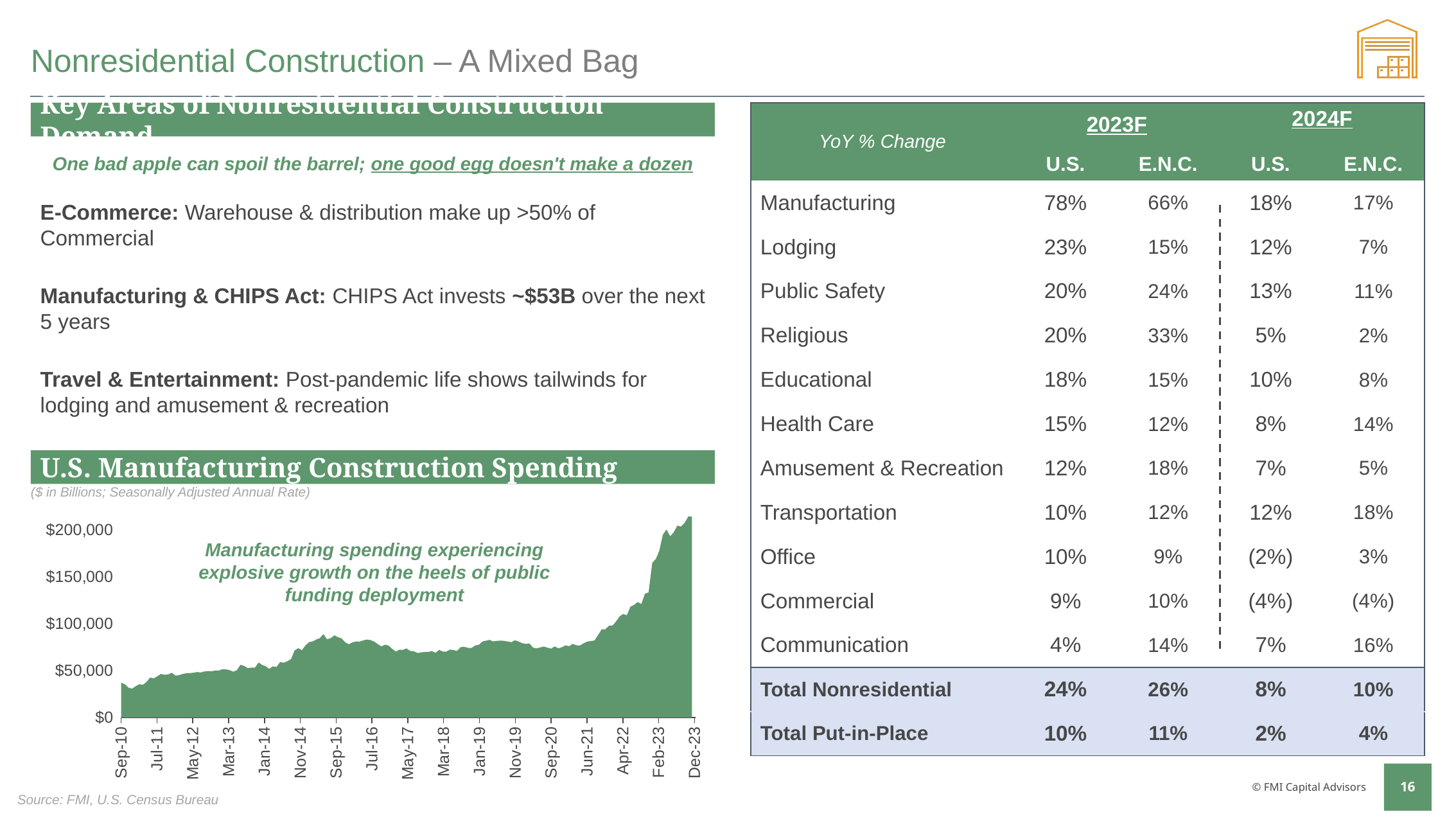
In the U.S. Manufacturing Construction Spending chart, do values generally rise or fall from Sep-10 to Dec-23? Rise In the U.S. Manufacturing Construction Spending chart, is the value at Feb-23 greater or less than $150,000? greater In the U.S. Manufacturing Construction Spending chart, which labeled period on the x axis has the highest value? Dec-23 What units does the subtitle of the U.S. Manufacturing Construction Spending chart state? $ in Billions; Seasonally Adjusted Annual Rate In the U.S. Manufacturing Construction Spending chart, is the value at Sep-15 greater or less than $100,000? less What kind of chart is the U.S. Manufacturing Construction Spending chart? Area chart In the U.S. Manufacturing Construction Spending chart, which labeled period on the x axis has the lowest value? Sep-10 In the U.S. Manufacturing Construction Spending chart, is the value at Sep-10 greater or less than $50,000? less What is the highest tick label on the y axis of the U.S. Manufacturing Construction Spending chart? $200,000 In the U.S. Manufacturing Construction Spending chart, is the value at Dec-23 larger or smaller than the value at Sep-15? Larger